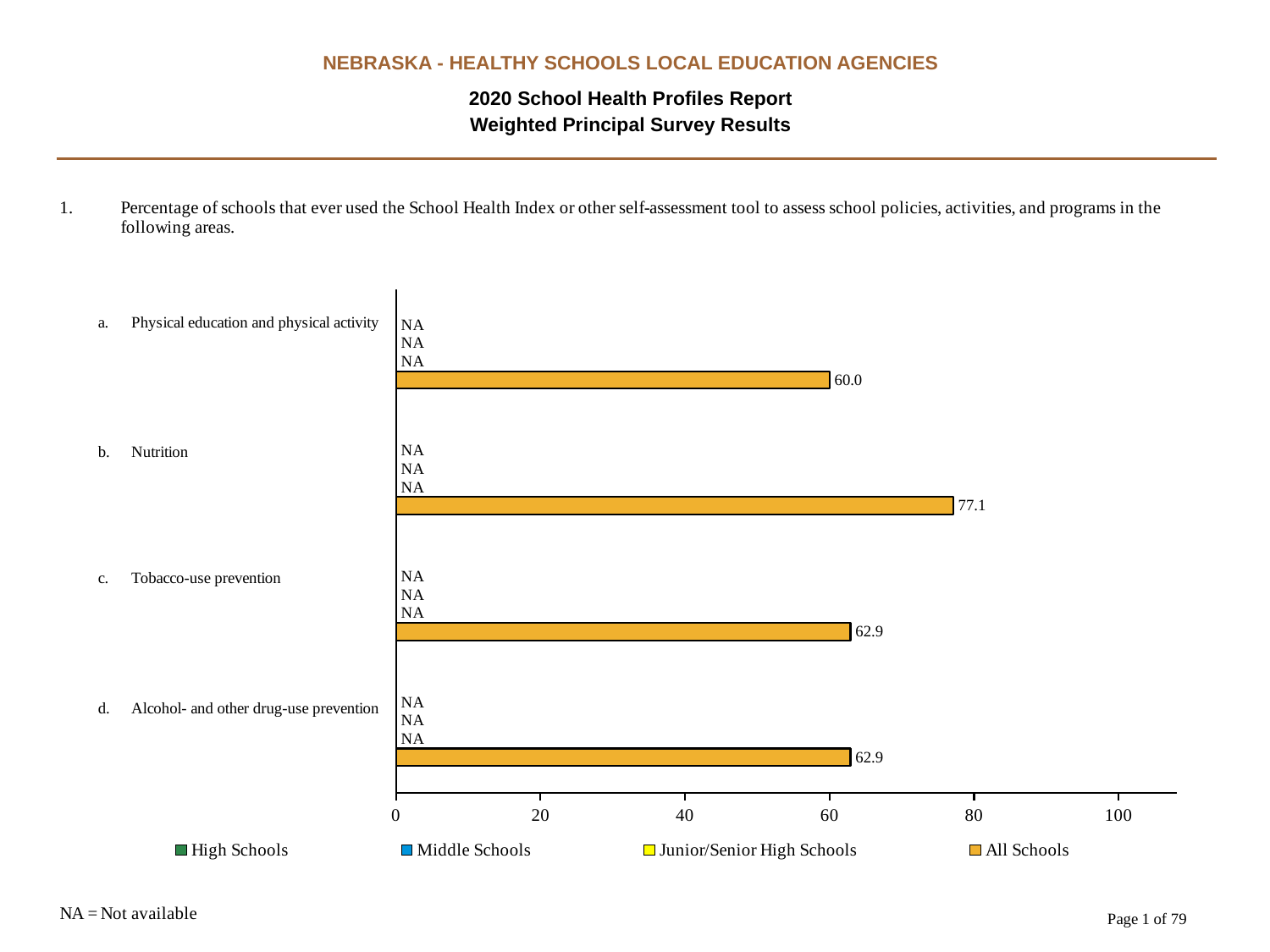
What is the All Schools value for Nutrition? 77.1 What is the All Schools value for Tobacco-use prevention? 62.9 How many areas (categories) are shown in the chart? 4 Which is larger for All Schools: Nutrition or Tobacco-use prevention? Nutrition Which area has the highest All Schools value? Nutrition What is the difference between the All Schools values for Nutrition and Physical education and physical activity? 17.1 What value is shown for High Schools for Nutrition? NA Which area has the lowest All Schools value? Physical education and physical activity What is the All Schools value for Alcohol- and other drug-use prevention? 62.9 What is the All Schools value for Physical education and physical activity? 60.0 How many series does the legend list? 4 What kind of chart is shown on the slide? Bar chart